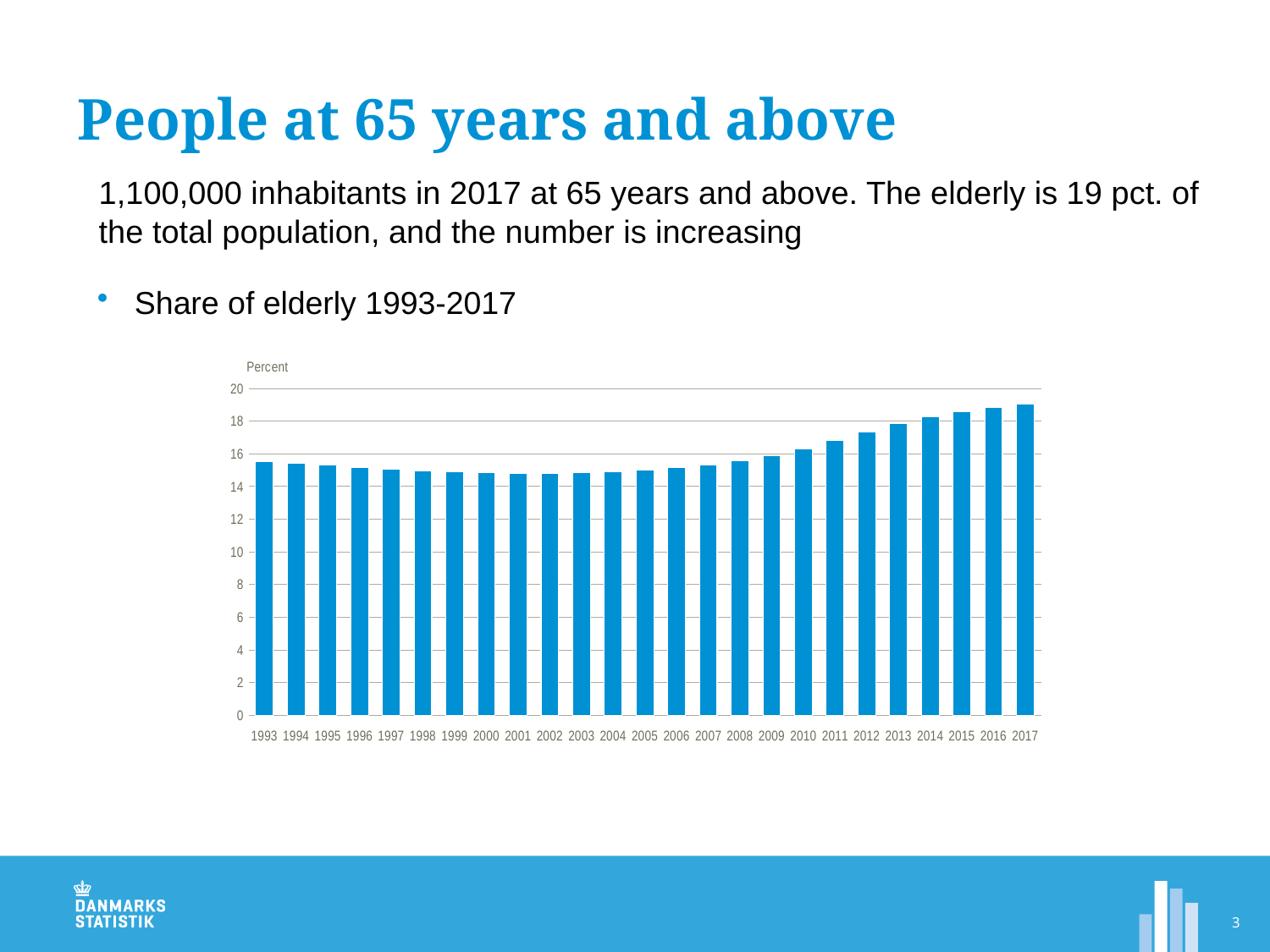
Is the value for 1993 greater or less than 16? less Which is larger, the value for 2000 or the value for 2014? 2014 Which is larger, the value for 2017 or the value for 1993? 2017 Is the value for 2017 greater or less than 18? greater Do the values rise or fall from 2003 to 2017? rise Which year has the highest share of elderly in the chart? 2017 What kind of chart is shown on the slide? bar chart What unit label is shown at the top of the vertical axis? Percent Is the value for 2012 greater or less than 16? greater How many years (bars) are plotted in the chart? 25